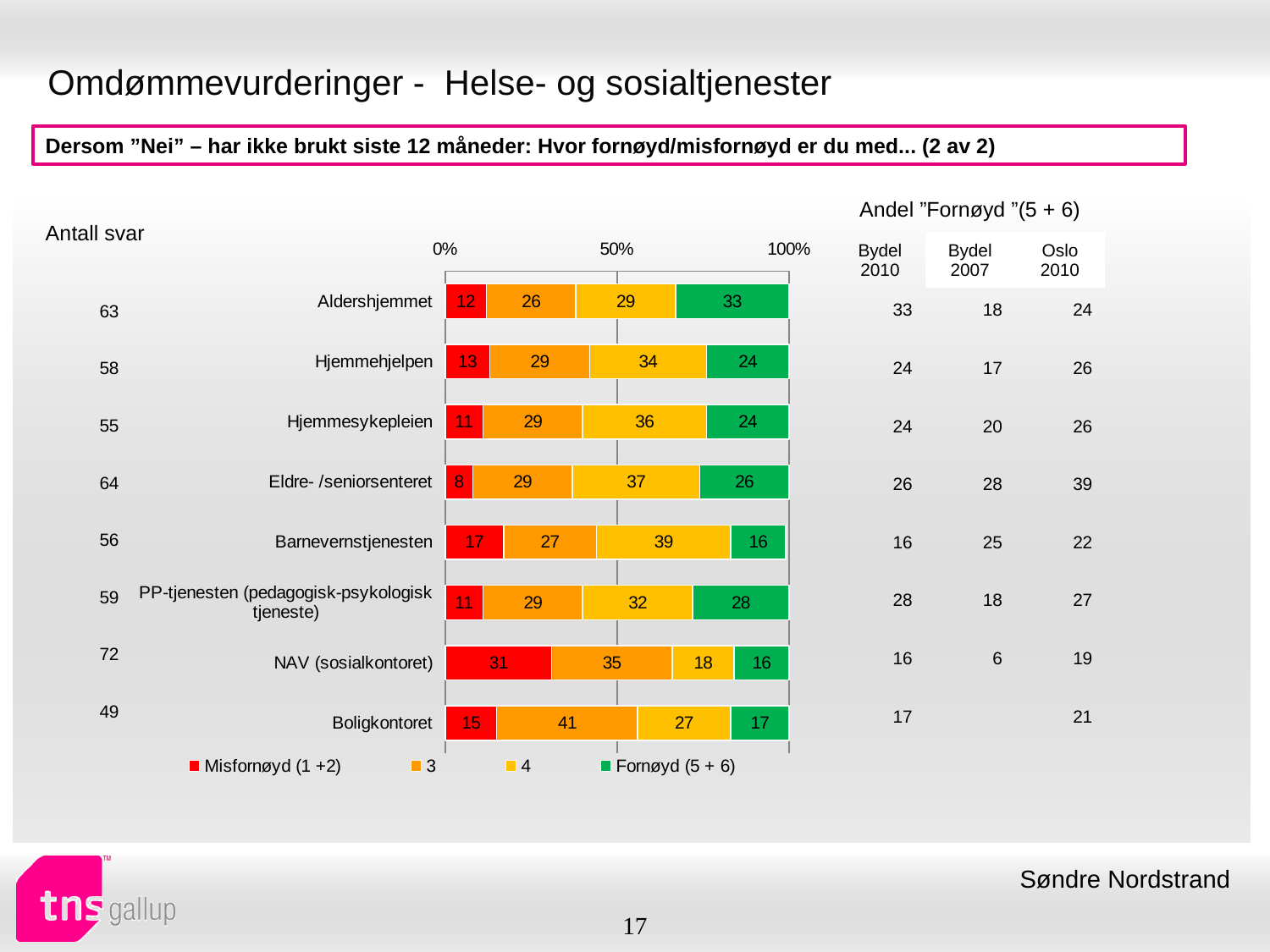
What is the total of the stacked bar for Boligkontoret? 100 How many categories are shown in the chart? 8 What is the value of the Misfornøyd (1 +2) segment for NAV (sosialkontoret)? 31 How many series does the legend list? 4 Which category has the lowest Misfornøyd (1 +2) value? Eldre- /seniorsenteret What is the value of the Fornøyd (5 + 6) segment for Aldershjemmet? 33 Which has a larger '4' segment value, Barnevernstjenesten or Boligkontoret? Barnevernstjenesten What kind of chart is shown on the slide? Stacked bar chart What is the value of the '3' segment for Boligkontoret? 41 Which category has the highest value for the '4' segment? Barnevernstjenesten What is the difference between the Fornøyd (5 + 6) values for Aldershjemmet and Barnevernstjenesten? 17 Which category has the highest Fornøyd (5 + 6) value? Aldershjemmet